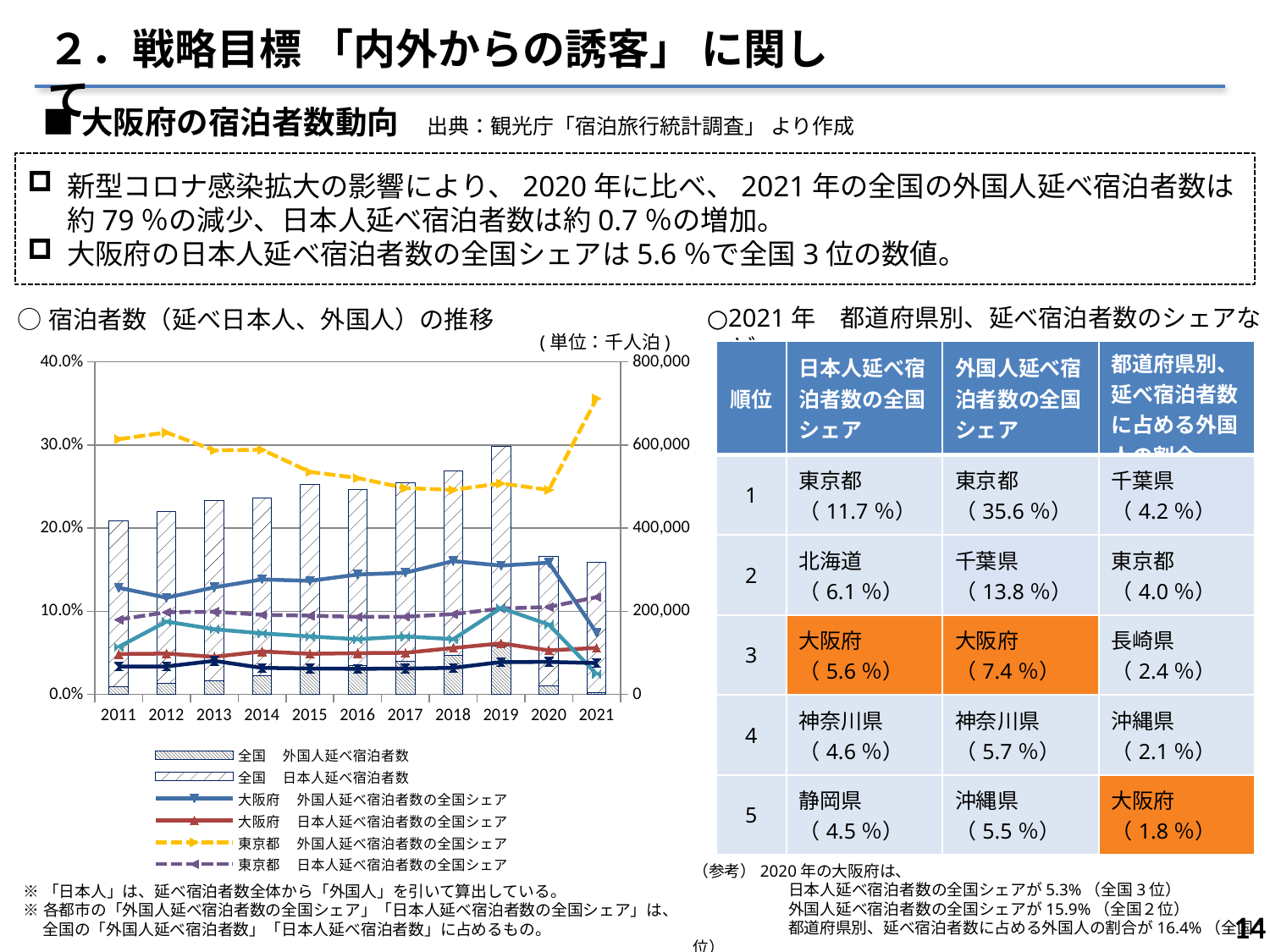
Is the value for 全国 日本人延べ宿泊者数 in 2021 greater or less than 400,000? less In which year is 東京都 外国人延べ宿泊者数の全国シェア highest? 2021 What unit is stated for the chart's right-hand axis? 千人泊 What kind of chart is shown on the slide? A combination bar and line chart Is the value for 東京都 外国人延べ宿泊者数の全国シェア in 2020 greater or less than 30.0%? less In which year is 全国 日本人延べ宿泊者数 highest? 2019 Is the value for 全国 日本人延べ宿泊者数 in 2019 greater or less than 400,000? greater In 2019, which is larger: 大阪府 外国人延べ宿泊者数の全国シェア or 大阪府 日本人延べ宿泊者数の全国シェア? 大阪府 外国人延べ宿泊者数の全国シェア How many years are shown on the x axis of the chart? 11 How many series does the chart legend list? 6